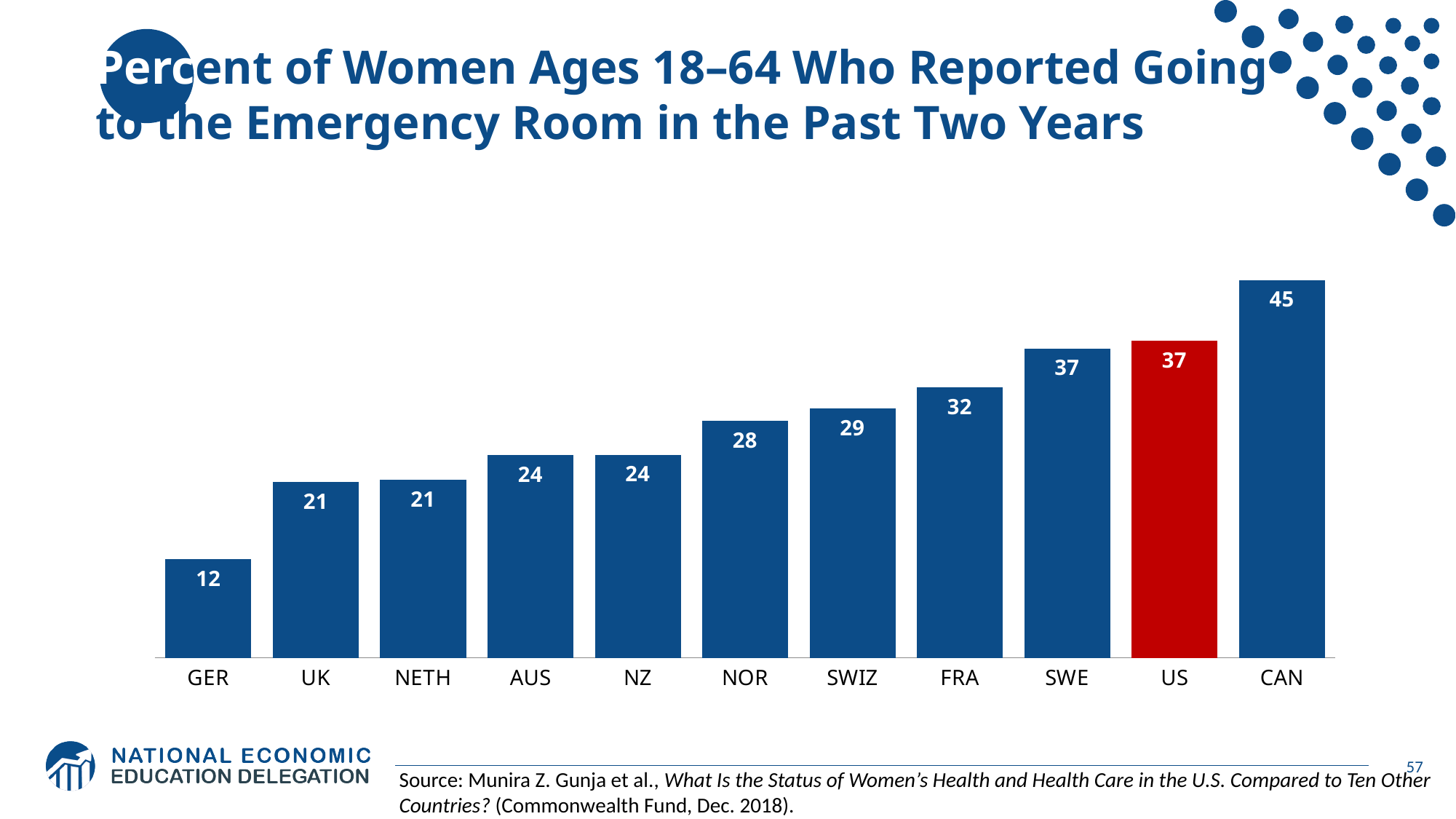
What kind of chart is shown on the slide? Bar chart Which country has the lowest value? GER What is the difference between the values for FRA and GER? 20 What is the value for GER? 12 What is the value for the US? 37 Which is larger, the value for SWIZ or the value for NZ? SWIZ Do the values rise or fall from left to right across the chart? Rise Which bar is coloured red instead of blue? US What is the difference between the values for CAN and the US? 8 What is the value for NOR? 28 Which country has the highest value? CAN How many countries are shown on the chart? 11